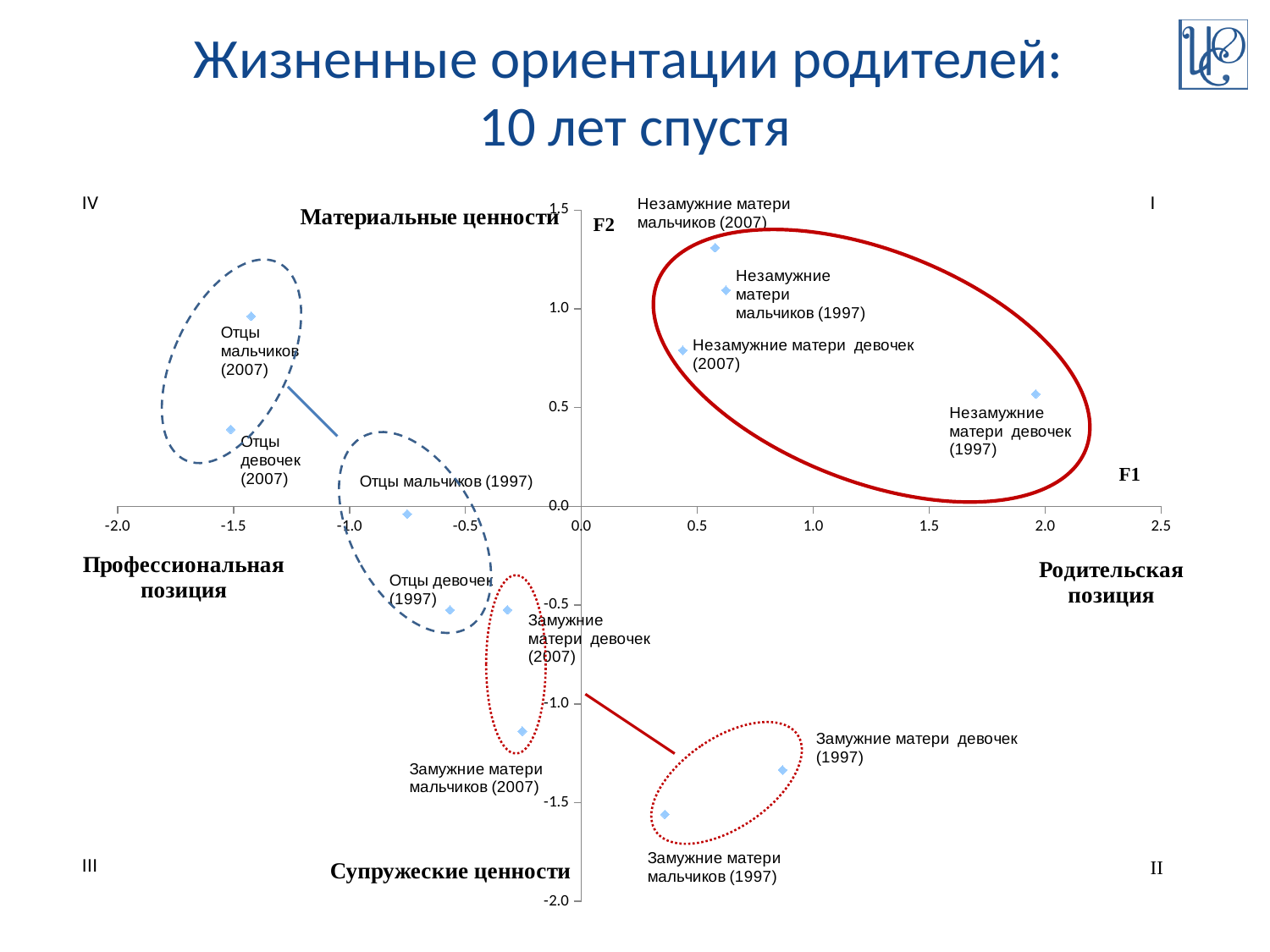
Which group has the highest F2 value on the chart? Незамужние матери мальчиков (2007) Is the F1 value for Отцы девочек (2007) greater or less than -1.0? less Which has the larger F2 value: Отцы мальчиков (2007) or Отцы девочек (2007)? Отцы мальчиков (2007) What kind of chart is shown on the slide? scatter plot What label is written at the top of the vertical axis of the chart? Материальные ценности Which group has the highest F1 value on the chart? Незамужние матери девочек (1997) Which group has the lowest F2 value on the chart? Замужние матери мальчиков (1997) Is the F2 value for Замужние матери мальчиков (1997) greater or less than -1.0? less Is the F2 value for Незамужние матери мальчиков (2007) greater or less than 1.0? greater How many labelled data points are plotted on the chart? 12 Which has the larger F1 value: Незамужние матери девочек (1997) or Незамужние матери мальчиков (1997)? Незамужние матери девочек (1997)